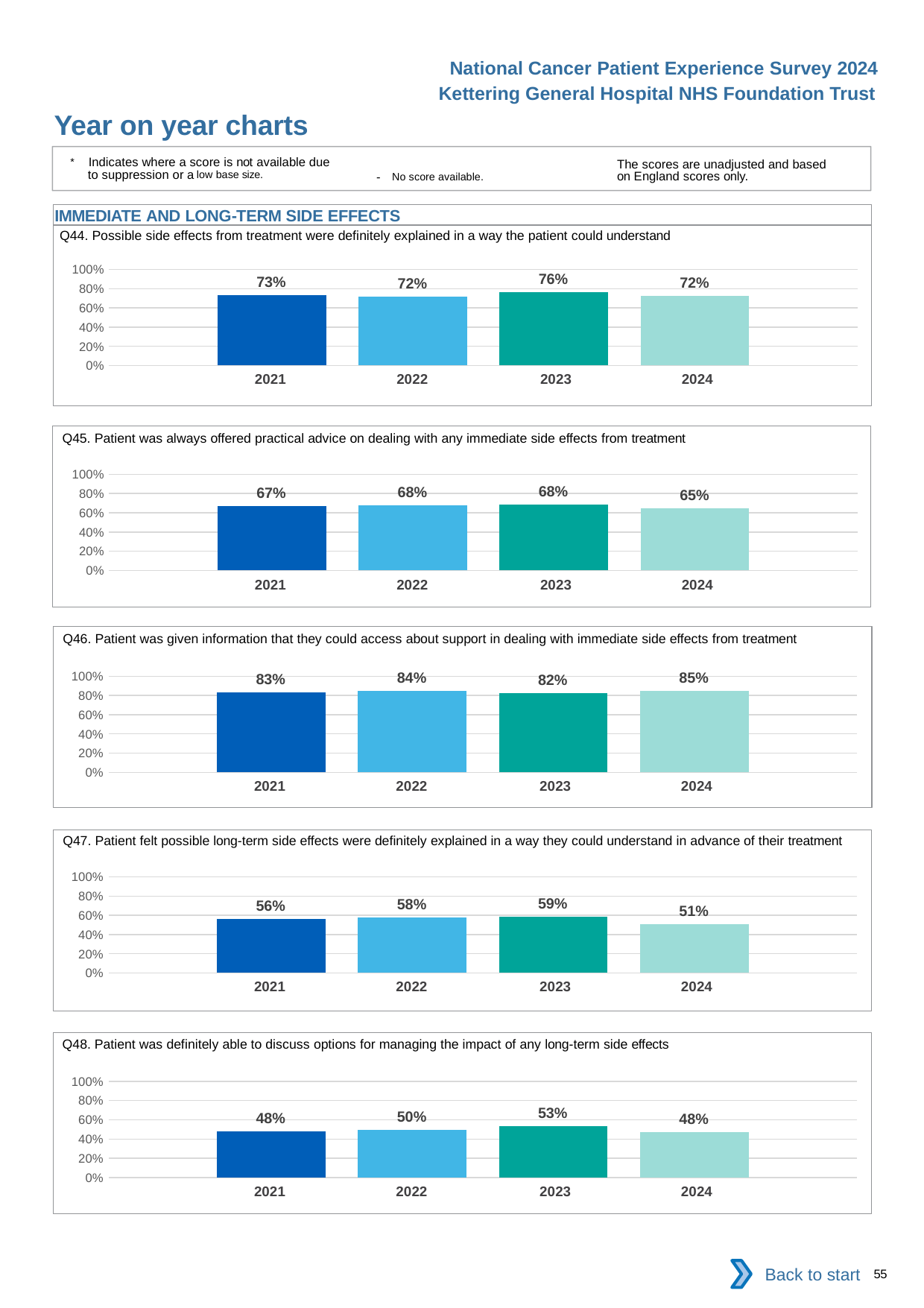
In the Q48 chart, is the value for 2023 greater or less than 60%? less What kind of chart is the Q46 chart? bar chart What is the section heading above the Q44 chart? IMMEDIATE AND LONG-TERM SIDE EFFECTS In the Q47 chart, what is the difference between the 2023 and 2024 values? 8% In the Q48 chart, what is the value for 2022? 50% In the Q47 chart, do the values rise or fall from 2021 to 2023? rise In the Q46 chart, which year has the highest value? 2024 In the Q44 chart, what is the value for 2023? 76% In the Q45 chart, what is the difference between the 2022 and 2024 values? 3% In the Q47 chart, which is larger, the value for 2021 or the value for 2024? 2021 How many years are shown in the Q44 chart? 4 In the Q45 chart, which year has the lowest value? 2024